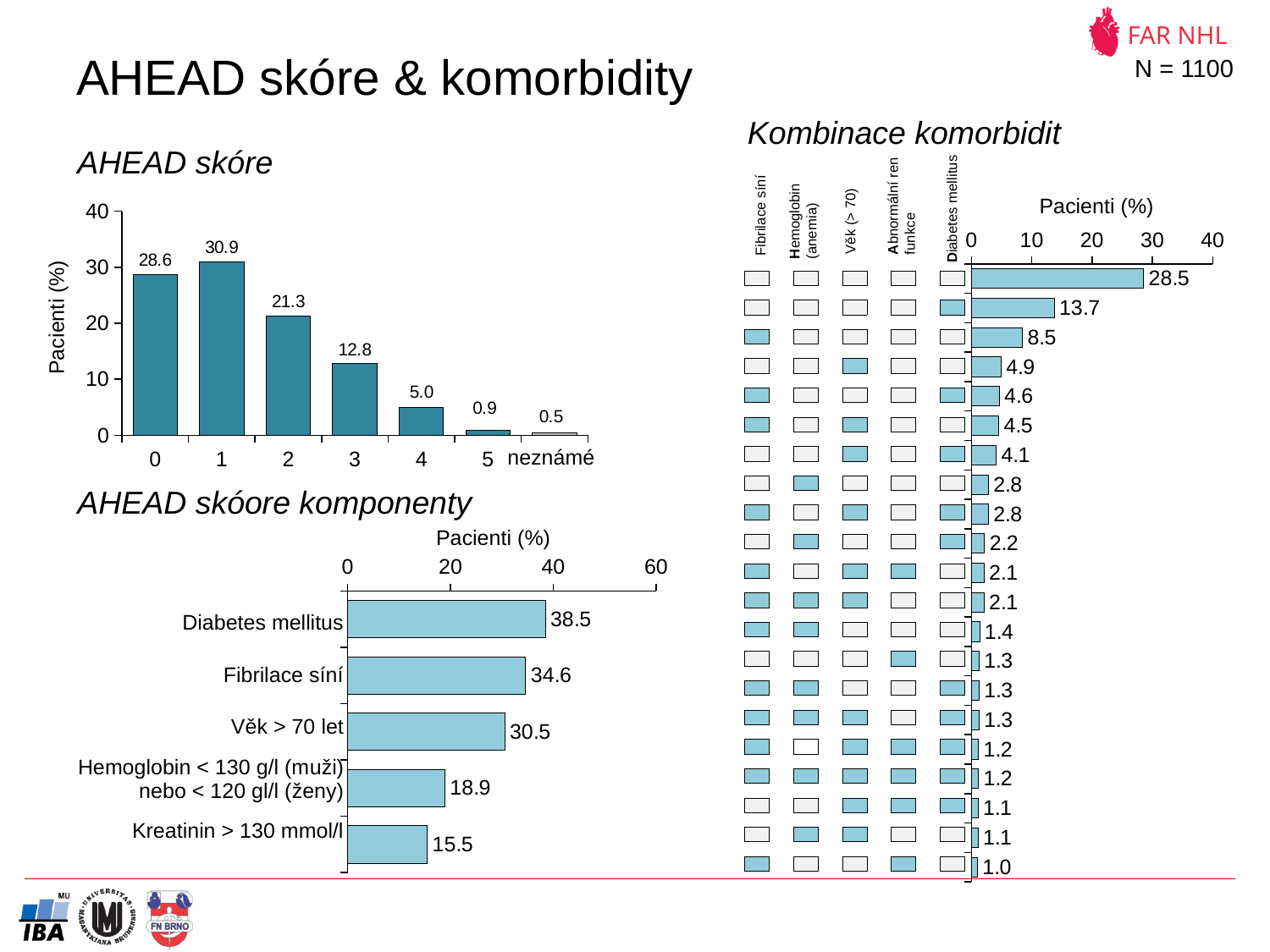
How many categories are shown on the x axis of the AHEAD skóre chart? 7 In the AHEAD skóre chart, what percentage of patients have a score of 1? 30.9 In the AHEAD skóore komponenty chart, what is the value for Fibrilace síní? 34.6 In the AHEAD skóre chart, what is the value for score 3? 12.8 In the AHEAD skóre chart, which score category has the highest percentage of patients? 1 What type of chart is the AHEAD skóore komponenty chart? bar chart In the AHEAD skóore komponenty chart, which component has the highest percentage of patients? Diabetes mellitus In the AHEAD skóre chart, what is the difference between the values for score 0 and score 2? 7.3 In the Kombinace komorbidit chart, what is the value of the longest bar? 28.5 In the AHEAD skóre chart, which category has the lowest value? neznámé In the AHEAD skóre chart, do the values rise or fall from score 1 to score 5? fall In the AHEAD skóore komponenty chart, which is larger: Věk > 70 let or Kreatinin > 130 mmol/l? Věk > 70 let